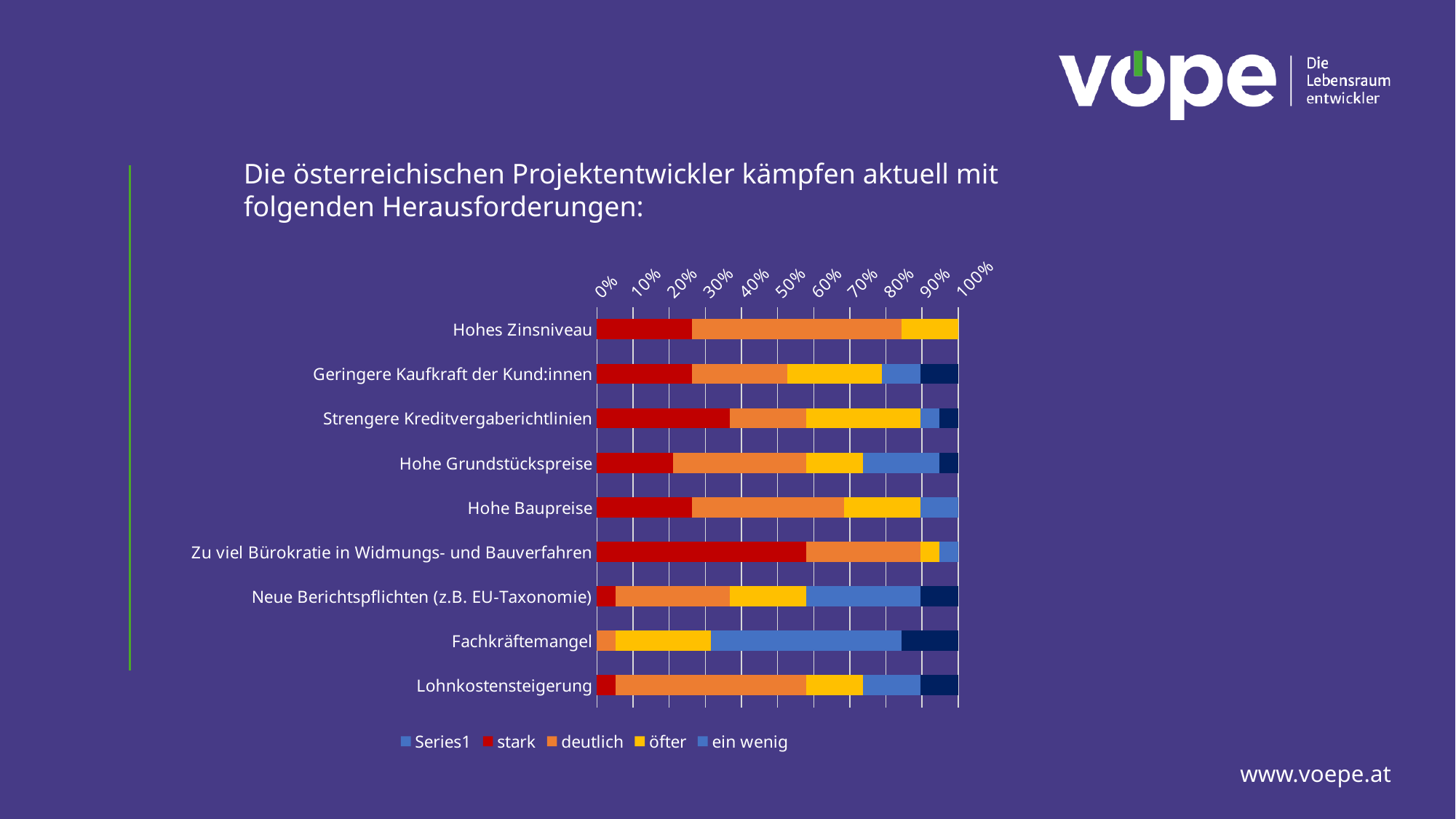
Is the 'stark' value for 'Hohes Zinsniveau' greater or less than 20%? greater Is the 'stark' value for 'Neue Berichtspflichten (z.B. EU-Taxonomie)' greater or less than 10%? less Which category has the largest 'ein wenig' (light blue) segment? Fachkräftemangel What kind of chart is shown on the slide? Stacked bar chart Is the 'stark' value for 'Zu viel Bürokratie in Widmungs- und Bauverfahren' greater or less than 50%? greater What is the first entry listed in the chart legend? Series1 Which has the larger 'ein wenig' segment: 'Fachkräftemangel' or 'Hohe Baupreise'? Fachkräftemangel Which category has the largest 'stark' (red) segment? Zu viel Bürokratie in Widmungs- und Bauverfahren How many challenge categories are listed on the vertical axis of the chart? 9 How many series does the chart legend list? 5 Which has the larger 'stark' segment: 'Hohe Baupreise' or 'Lohnkostensteigerung'? Hohe Baupreise